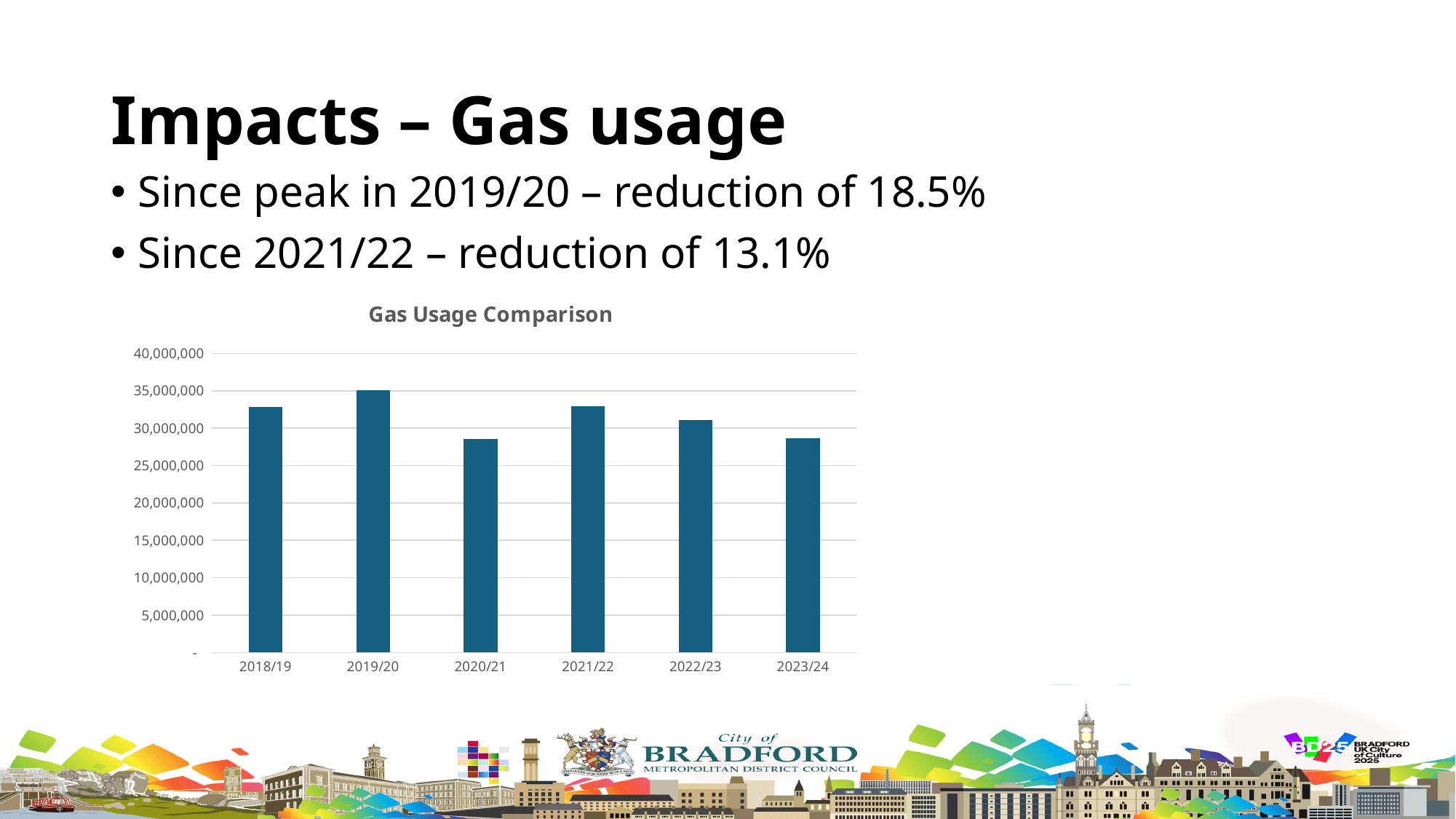
Is the value for 2023/24 greater or less than 30,000,000? less Is the value for 2022/23 greater or less than 30,000,000? greater Which is larger, the value for 2019/20 or the value for 2020/21? 2019/20 Which year has the highest gas usage in the chart? 2019/20 Which is larger, the value for 2018/19 or the value for 2020/21? 2018/19 Is the value for 2019/20 greater or less than 30,000,000? greater Which is larger, the value for 2022/23 or the value for 2023/24? 2022/23 What is the title of the chart? Gas Usage Comparison How many years are shown on the x axis of the chart? 6 What kind of chart is shown on the slide? bar chart